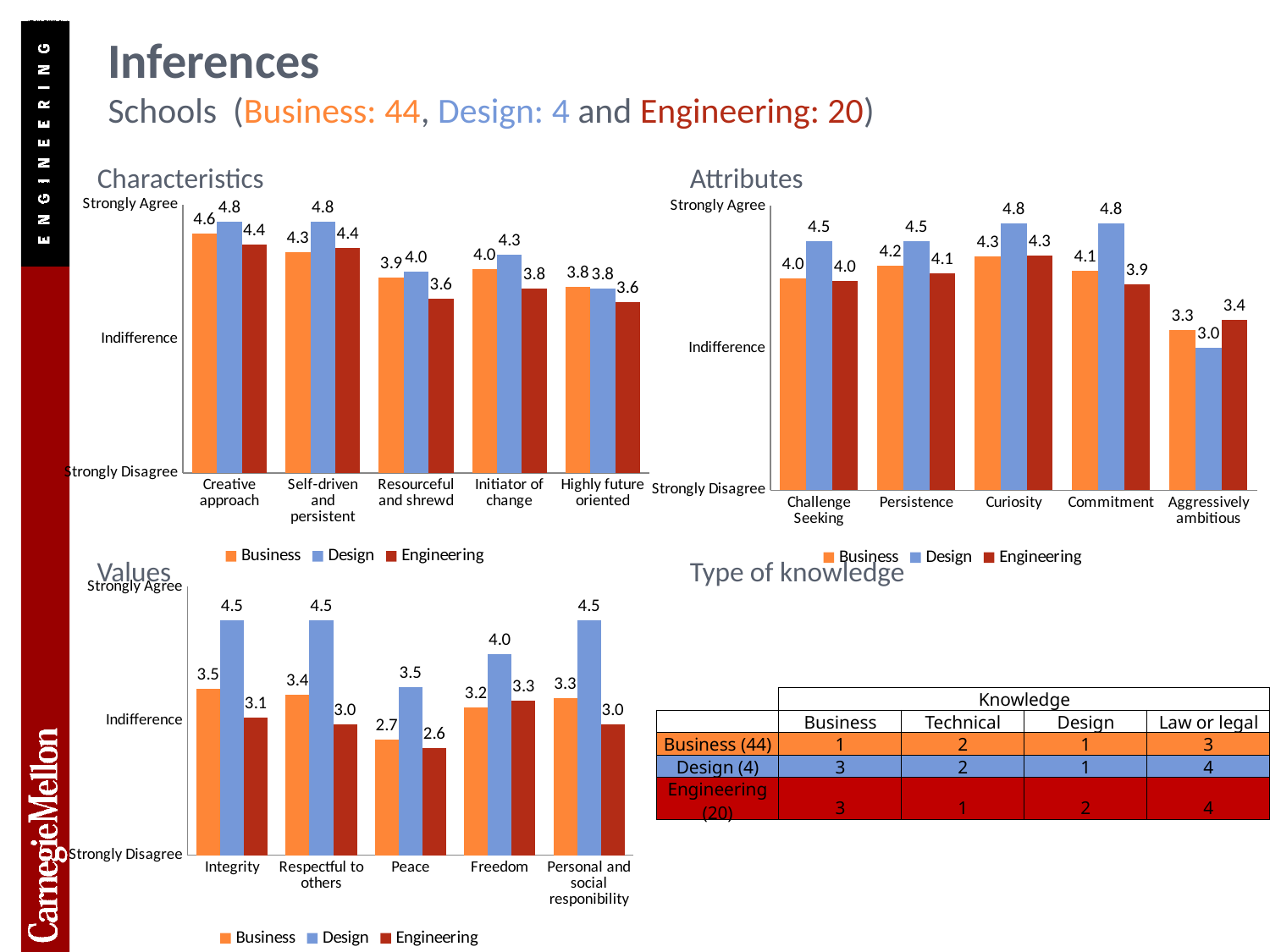
In the Attributes chart, what is the difference between the Design and Engineering values for Commitment? 0.9 In the Attributes chart, which category has the lowest Design value? Aggressively ambitious What type of chart is the Attributes chart? Bar chart In the Characteristics chart, what is the Engineering value for Resourceful and shrewd? 3.6 In the Values chart, what is the Design value for Freedom? 4.0 In the Values chart, what is the difference between the Design and Business values for Integrity? 1.0 In the Characteristics chart, what is the Design value for Creative approach? 4.8 In the Attributes chart, what is the Business value for Persistence? 4.2 In the Characteristics chart, how many categories are shown on the x axis? 5 In the Attributes chart, which is larger for Aggressively ambitious: the Business value or the Engineering value? Engineering In the Values chart, which category has the lowest Engineering value? Peace How many series does the legend of the Values chart list? 3